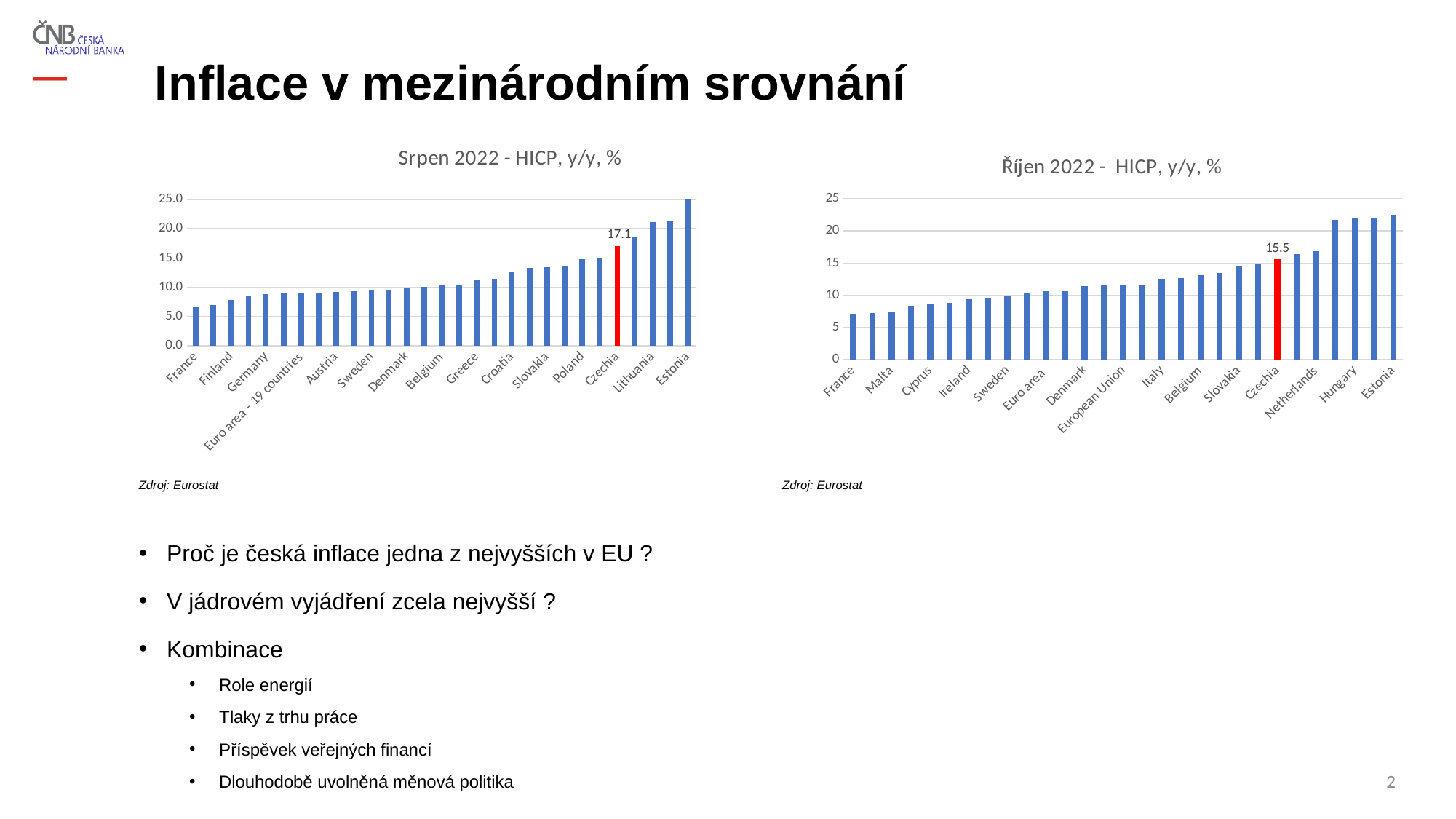
In the right chart (Říjen 2022), is the value for Malta greater or less than 10? less In the right chart (Říjen 2022), which is larger, the value for Netherlands or the value for Czechia? Netherlands In the left chart (Srpen 2022), is the value for Lithuania greater or less than 20.0? greater In the left chart (Srpen 2022), which country has the highest HICP inflation? Estonia What kind of chart is the left chart (Srpen 2022 - HICP, y/y, %)? Bar chart In the chart titled 'Říjen 2022 - HICP, y/y, %', what value is labelled for Czechia? 15.5 By how much does the labelled Czechia value in the left chart (Srpen 2022) exceed the labelled Czechia value in the right chart (Říjen 2022)? 1.6 In the right chart (Říjen 2022), do the values rise or fall from left to right along the x axis? Rise In the right chart (Říjen 2022), which country has the lowest HICP inflation? France In the chart titled 'Srpen 2022 - HICP, y/y, %', what value is labelled for Czechia? 17.1 In the left chart (Srpen 2022), which is larger, the value for Czechia or the value for Poland? Czechia In both charts, which country's bar is coloured red? Czechia